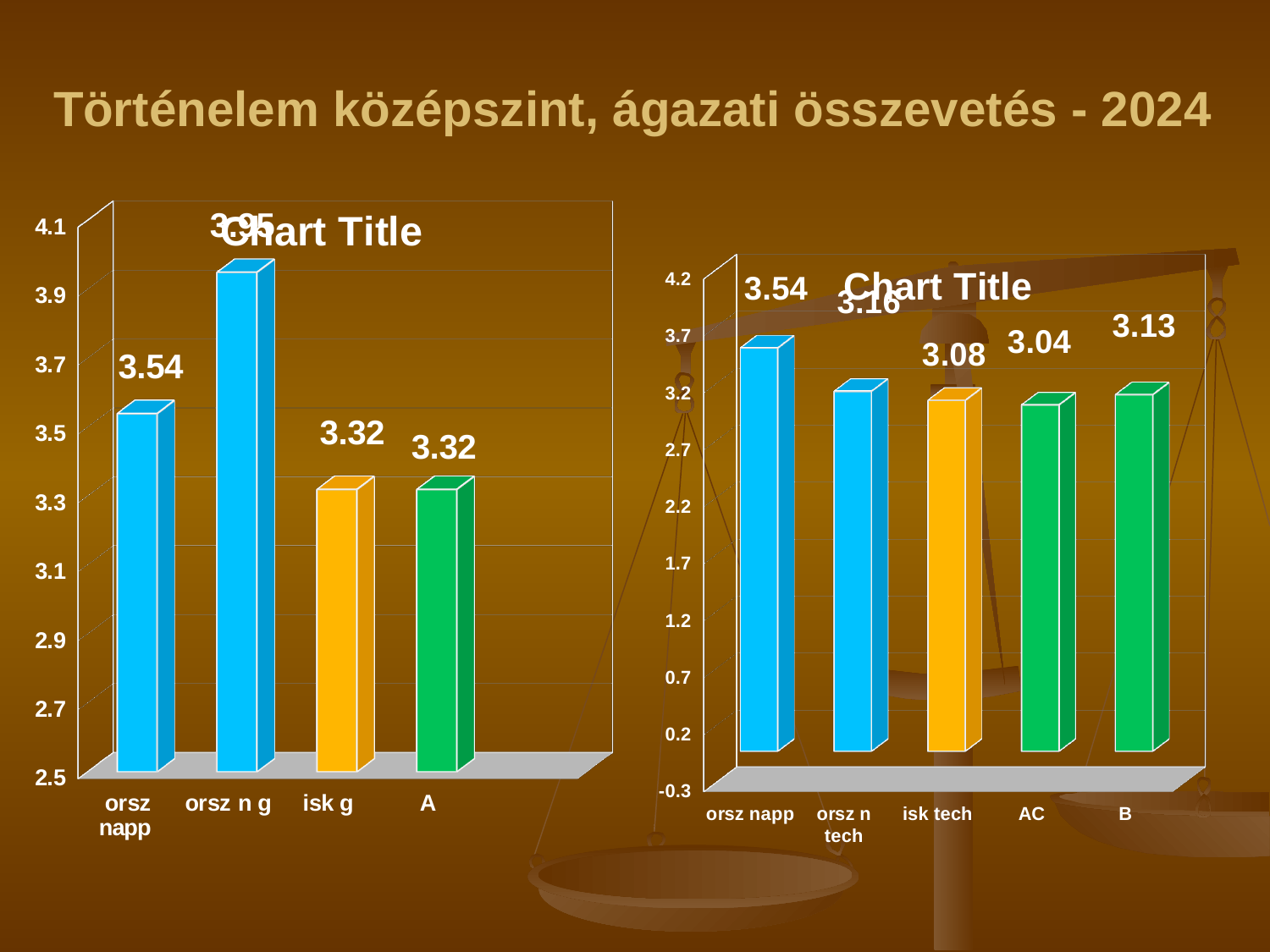
On the left chart, what is the value for isk g? 3.32 On the left chart, what is the value for orsz napp? 3.54 On the right chart, what is the value for B? 3.13 On the right chart, what is the value for orsz n tech? 3.16 On the left chart, is the value for orsz n g greater or less than 3.7? greater On the right chart, how many categories are shown? 5 On the right chart, what is the difference between the values for orsz napp and isk tech? 0.46 On the left chart, which category has the highest value? orsz n g What type of chart is the right chart? bar chart On the right chart, which category has the highest value? orsz napp On the right chart, which category has the lowest value? AC On the left chart, how many categories are shown? 4